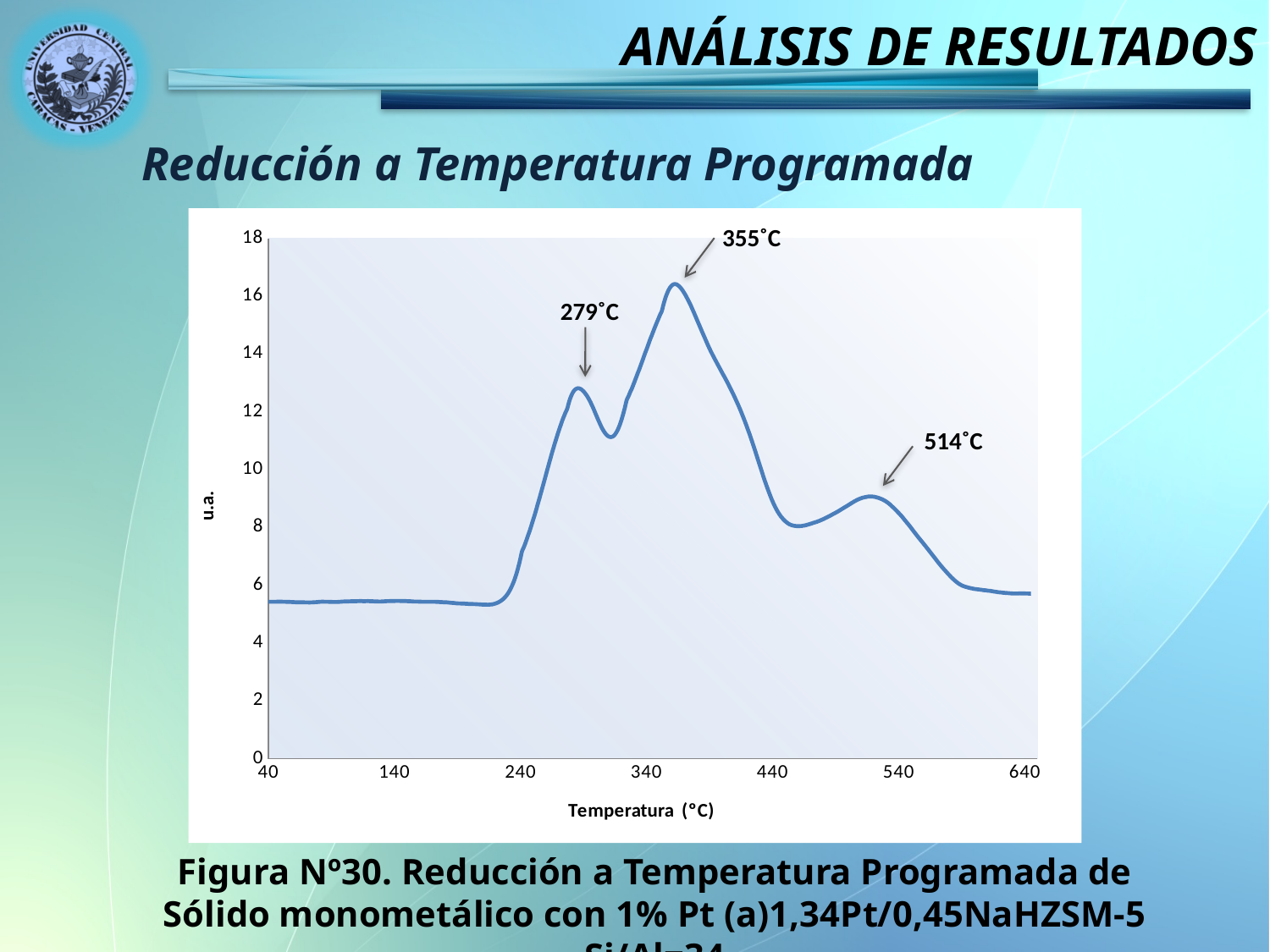
What is the label of the y axis of the chart? u.a. Does the signal rise or fall as the temperature increases from 240 to 355˚C? rise Which peak has a higher signal value, the one at 279˚C or the one at 514˚C? 279˚C What is the label of the x axis of the chart? Temperatura (°C) What kind of chart is shown on the slide? line chart At what temperature is the first annotated peak of the curve? 279˚C At what temperature is the tallest annotated peak of the curve? 355˚C Is the signal value at the 514˚C peak greater or less than 10? less At what temperature is the last annotated peak of the curve? 514˚C Is the signal value at the 355˚C peak greater or less than 14? greater Which of the annotated peaks has the lowest signal value? 514˚C How many peaks are annotated with a temperature on the chart? 3